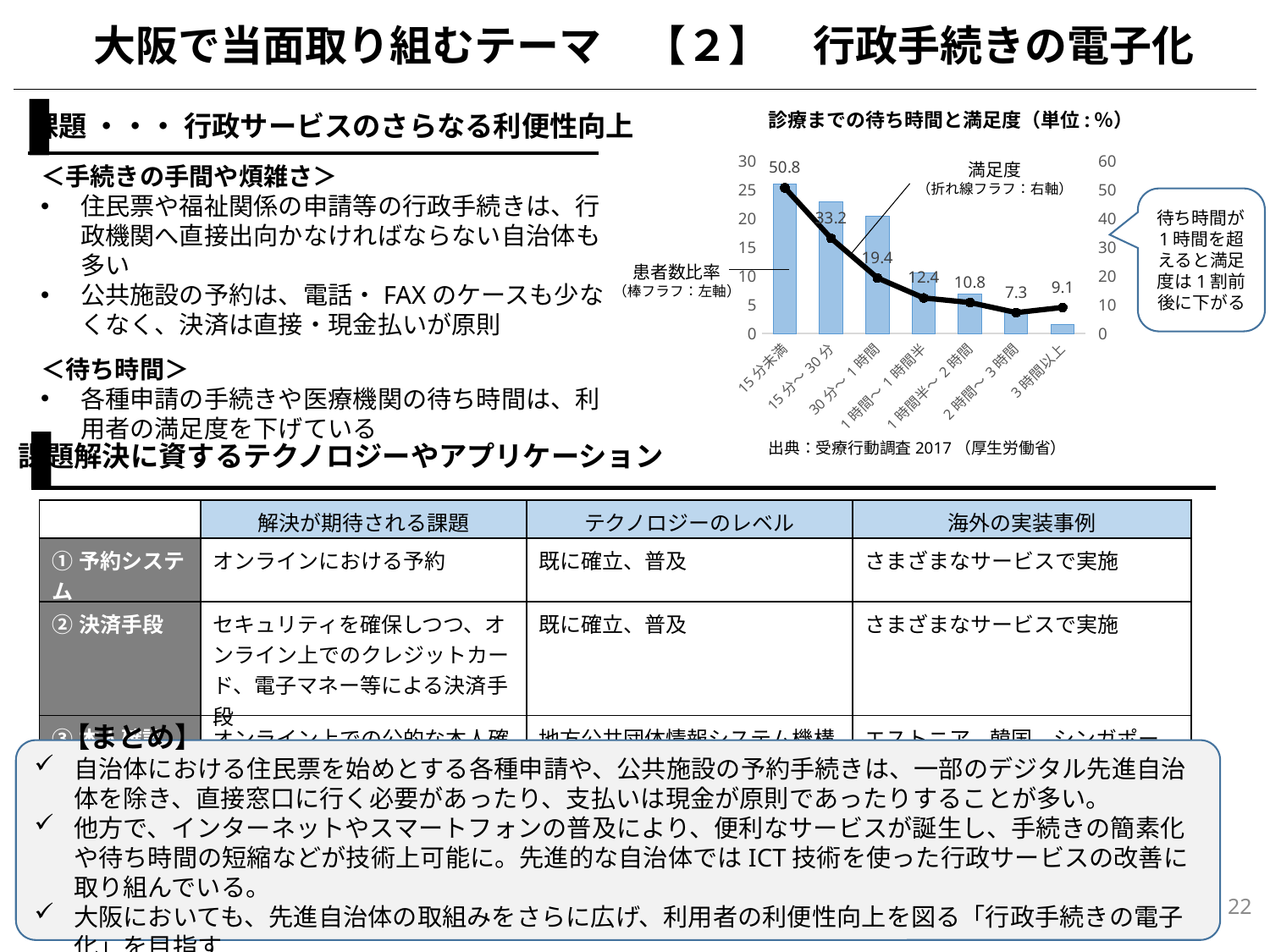
In the chart 診療までの待ち時間と満足度, what is the difference in 満足度 between 15分未満 and 15分～30分? 17.6 In the chart 診療までの待ち時間と満足度, does 満足度 rise or fall from 15分未満 to 2時間～3時間? fall In the chart 診療までの待ち時間と満足度, what is the 満足度 value for 2時間～3時間? 7.3 In the chart 診療までの待ち時間と満足度, which waiting-time category has the lowest 満足度? 2時間～3時間 How many waiting-time categories are shown on the x axis of the chart 診療までの待ち時間と満足度? 7 In the chart 診療までの待ち時間と満足度, which has the higher 満足度: 1時間～1時間半 or 3時間以上? 1時間～1時間半 In the chart 診療までの待ち時間と満足度, what is the 満足度 value for 3時間以上? 9.1 In the chart 診療までの待ち時間と満足度, what is the 満足度 value for 15分未満? 50.8 In the chart 診療までの待ち時間と満足度, is the 患者数比率 bar for 15分未満 greater or less than 20? greater How many data series are plotted in the chart 診療までの待ち時間と満足度? 2 In the chart 診療までの待ち時間と満足度, is the 患者数比率 bar for 3時間以上 greater or less than 5? less In the chart 診療までの待ち時間と満足度, which waiting-time category has the highest 満足度? 15分未満